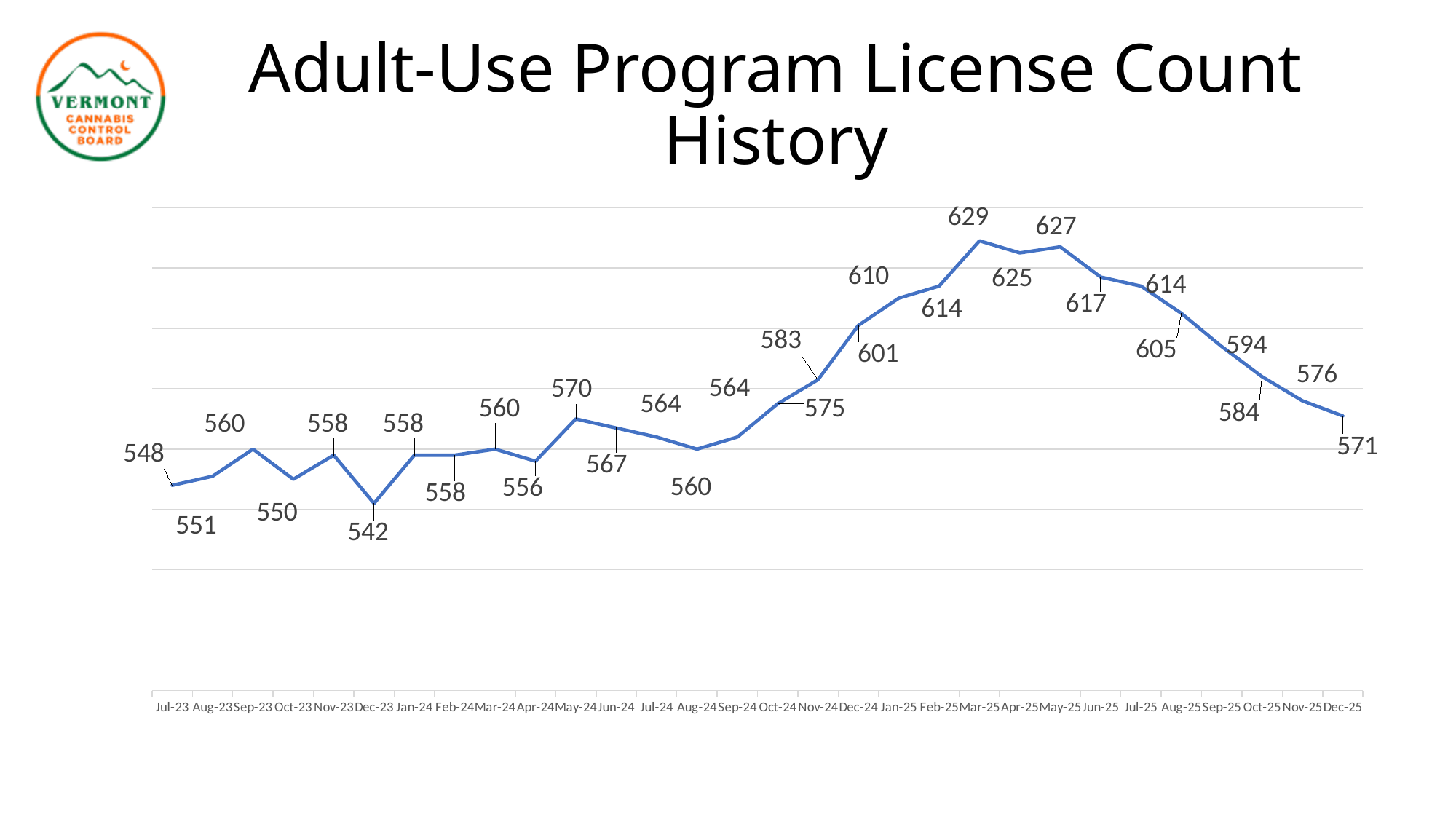
What is the license count for Dec-23? 542 What kind of chart is shown? Line chart Do the license counts rise or fall from Mar-25 to Dec-25? Fall What is the license count for Mar-25? 629 What is the difference between the license counts for Dec-24 and Nov-24? 18 What is the difference between the license counts for Mar-25 and Dec-23? 87 What is the license count for Jul-23? 548 Which month has the highest license count? Mar-25 Which month has the lowest license count? Dec-23 Which is larger, the license count for May-25 or Jun-25? May-25 How many months are plotted on the chart? 30 What is the license count for Dec-25? 571